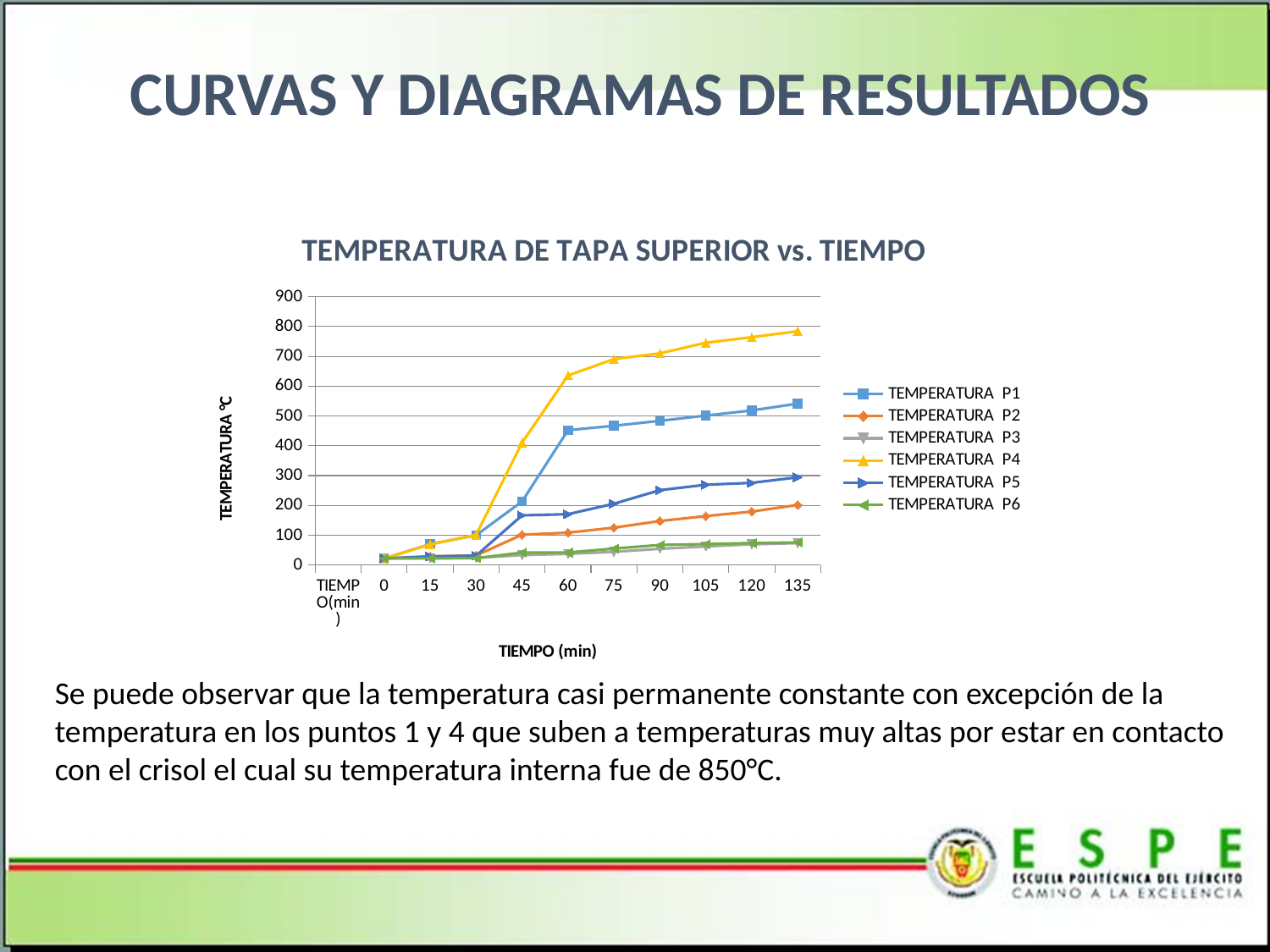
What is the label of the vertical axis? TEMPERATURA °C Does TEMPERATURA P4 rise or fall as time increases from 0 to 135 minutes? rises Is the value for TEMPERATURA P2 at 45 minutes greater or less than 200? less What is the title of the chart? TEMPERATURA DE TAPA SUPERIOR vs. TIEMPO Is the value for TEMPERATURA P4 at 135 minutes greater or less than 700? greater Is the value for TEMPERATURA P1 at 135 minutes greater or less than 500? greater How many series does the legend list? 6 What kind of chart is shown on the slide? line chart Which series reaches the highest temperature at 135 minutes? TEMPERATURA P4 At 135 minutes, which is larger: TEMPERATURA P1 or TEMPERATURA P5? TEMPERATURA P1